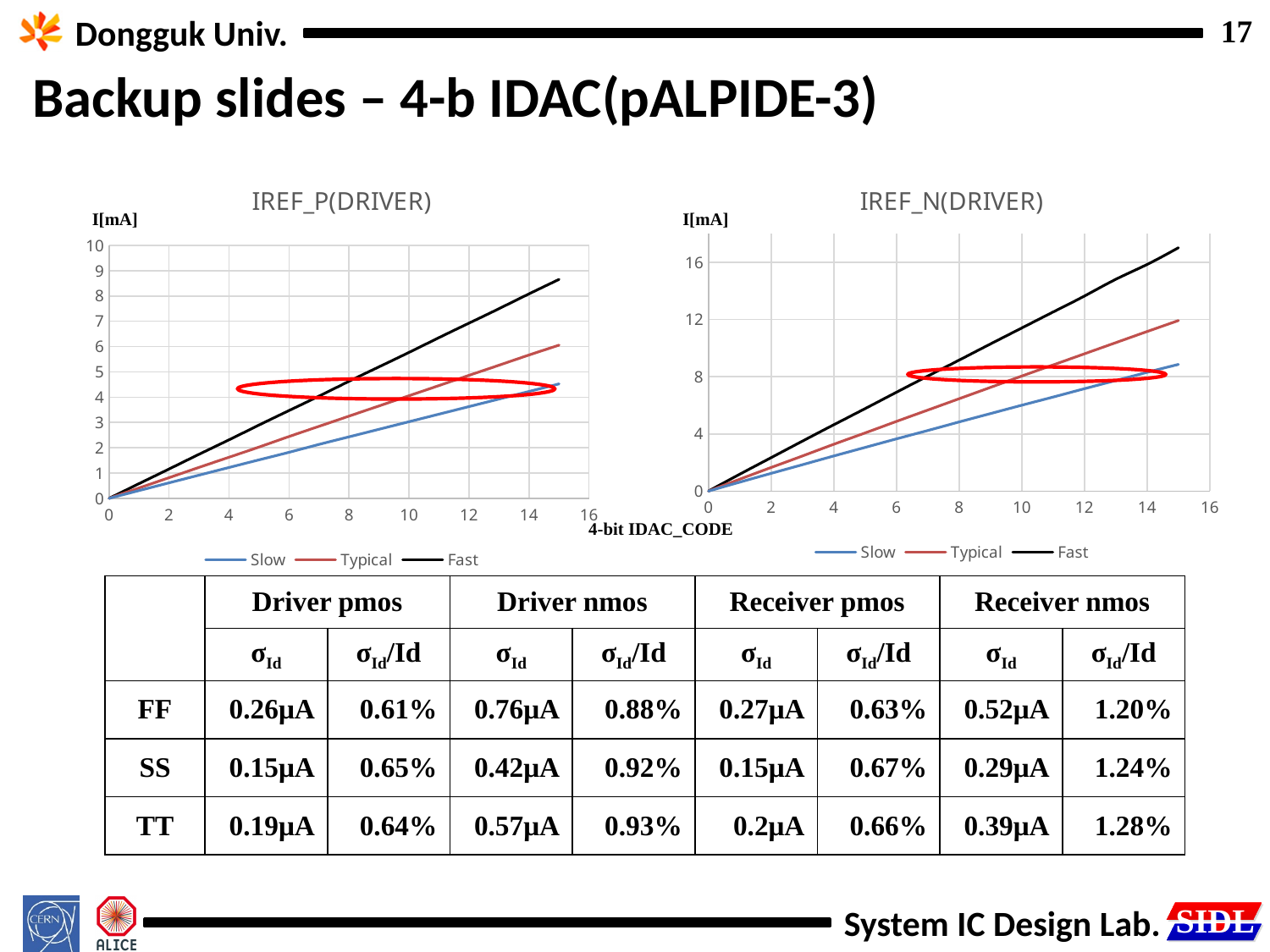
In the IREF_N(DRIVER) chart, which series has the lowest value at IDAC code 14? Slow In the IREF_P(DRIVER) chart, does the Fast series rise or fall as the IDAC code increases? rise What is the title of the chart on the right side of the slide? IREF_N(DRIVER) What kind of chart is the IREF_P(DRIVER) chart? line chart In the IREF_N(DRIVER) chart, which is larger at IDAC code 12, the Typical series or the Slow series? Typical In the IREF_P(DRIVER) chart, is the Fast value at IDAC code 12 greater or less than 6? greater In the IREF_P(DRIVER) chart, which series has the highest value at IDAC code 14? Fast In the IREF_P(DRIVER) chart, is the Slow value at IDAC code 14 greater or less than 5? less In the IREF_N(DRIVER) chart, is the Fast value at IDAC code 14 greater or less than 12? greater How many series does the legend of the IREF_N(DRIVER) chart list? 3 What are the legend entries of the IREF_P(DRIVER) chart? Slow, Typical, Fast